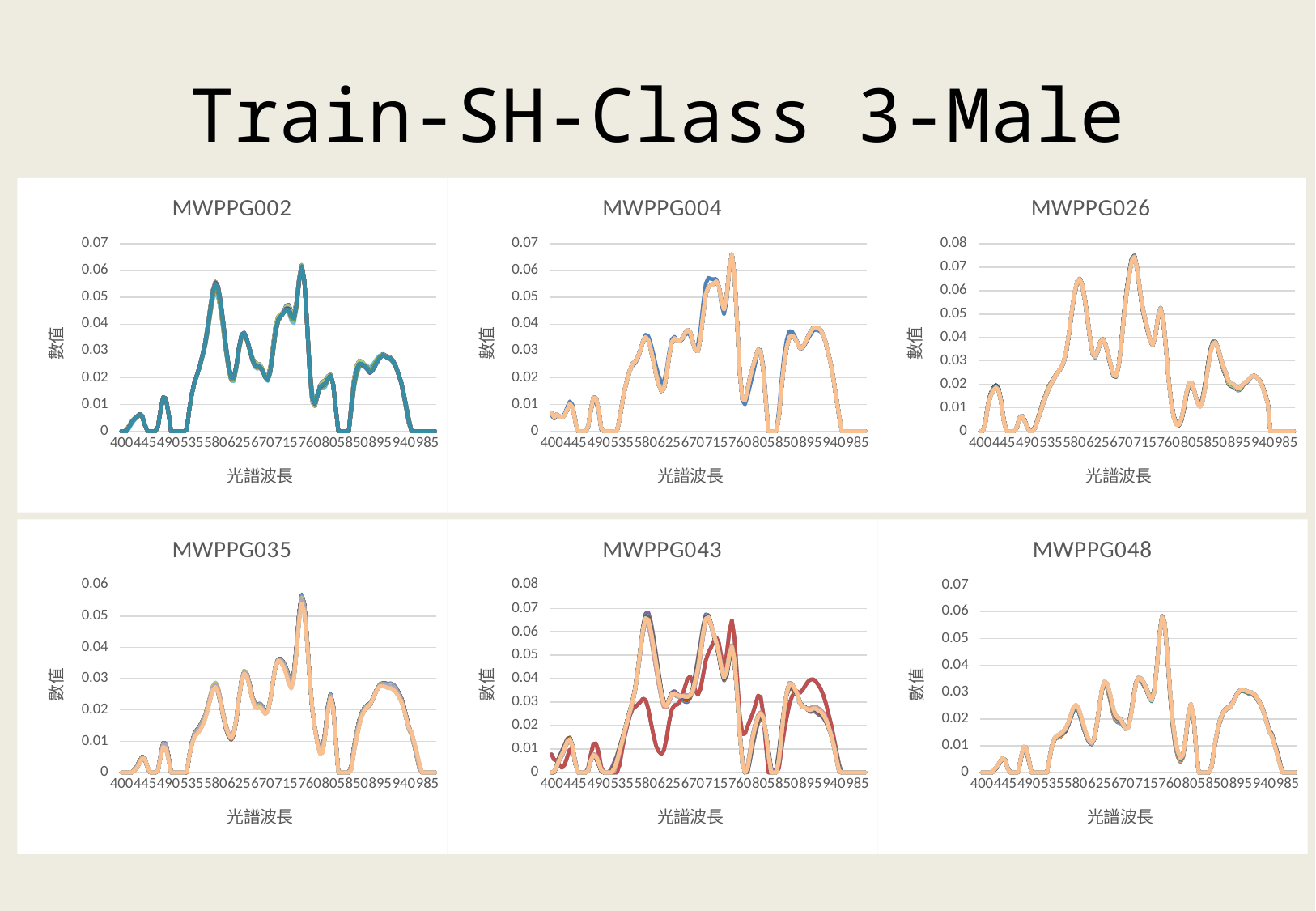
On the MWPPG035 chart, is the highest plotted value greater or less than 0.04? greater How many charts are shown on the slide? 6 On the MWPPG048 chart, is the highest plotted value greater or less than 0.05? greater On the MWPPG004 chart, is the value at 400 greater or less than 0.01? less On the MWPPG026 chart, what is the highest value labelled on the y axis? 0.08 What kind of chart is the MWPPG002 chart? line chart On the MWPPG035 chart, what is the highest value labelled on the y axis? 0.06 On the MWPPG002 chart, what is the plotted value at 400? 0 On the MWPPG043 chart, how many tick labels are shown on the x axis? 14